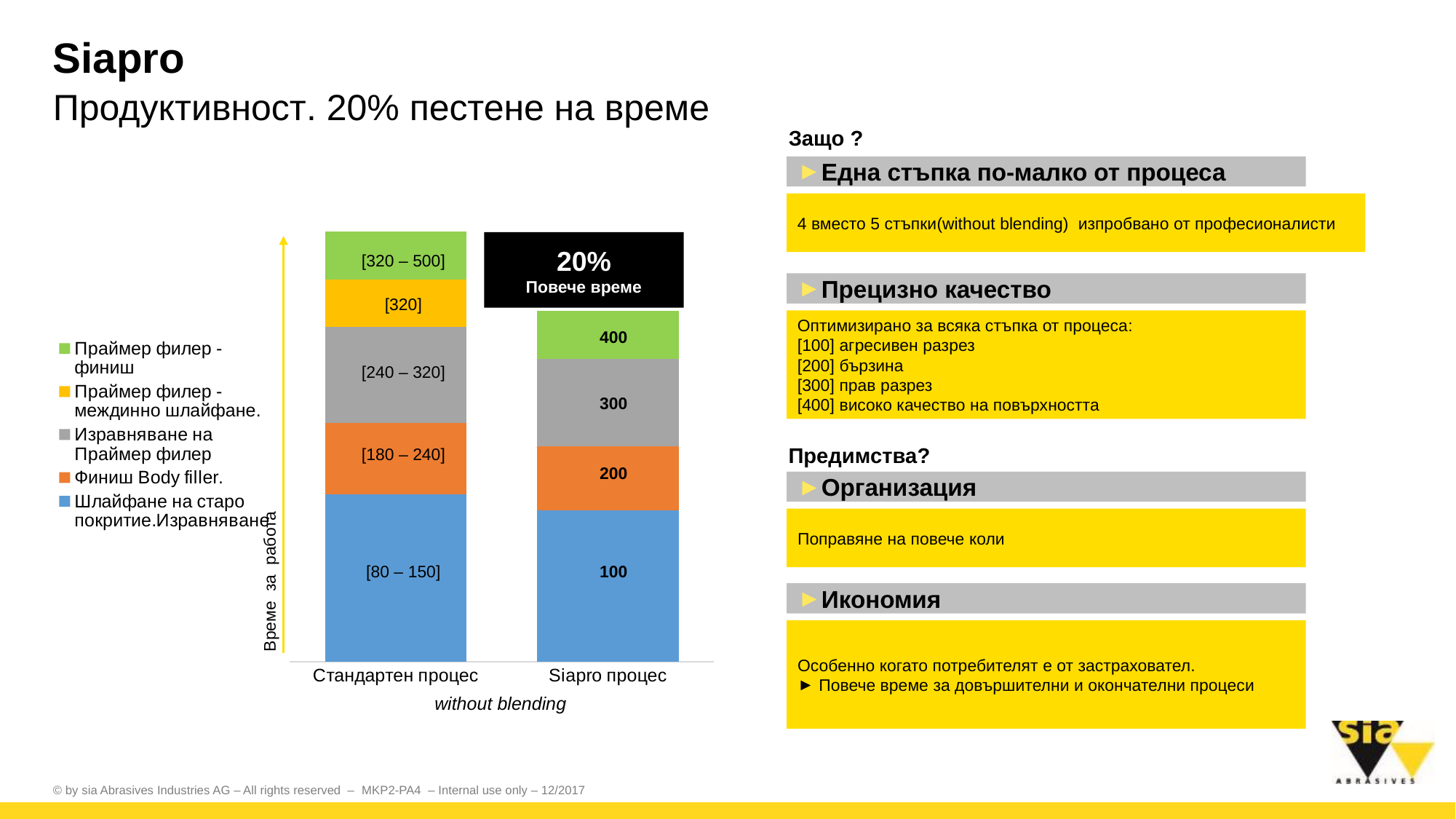
What label is printed on the orange segment of the Siapro процес bar? 200 What is the label of the vertical axis of the chart? Време за работа How many stacked segments does the Siapro процес bar have? 4 What label is printed on the green top segment of the Стандартен процес bar? [320 – 500] What text is written in the black box above the Siapro процес bar? 20% Повече време How many categories (bars) are shown on the x axis of the chart? 2 What label is printed on the yellow segment of the Стандартен процес bar? [320] How many series does the chart legend list? 5 What label is printed on the blue bottom segment of the Стандартен процес bar? [80 – 150] What kind of chart is shown on the slide? Stacked bar chart What label is printed on the blue bottom segment of the Siapro процес bar? 100 Which bar is taller, Стандартен процес or Siapro процес? Стандартен процес